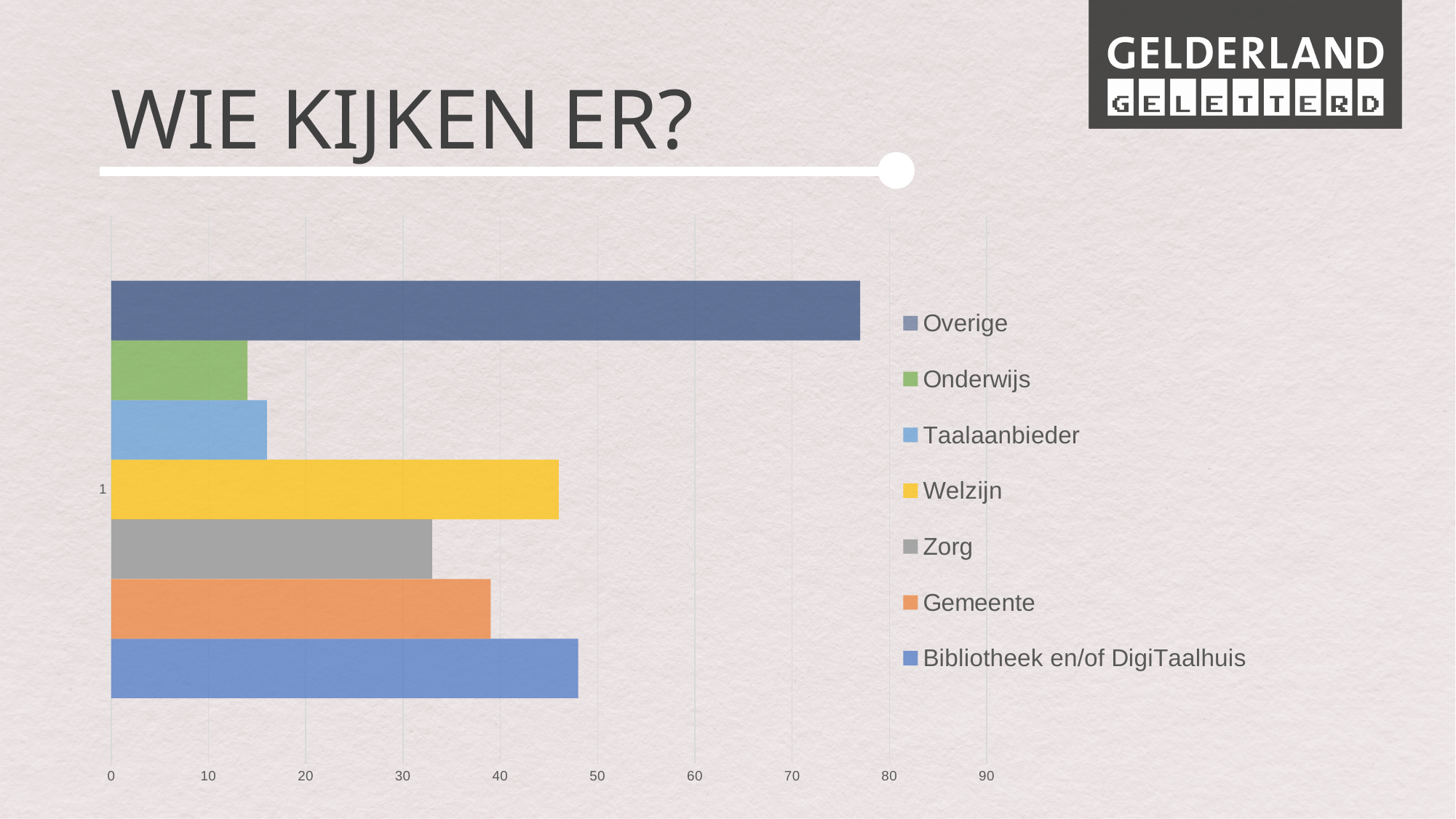
Is the value for Bibliotheek en/of DigiTaalhuis greater or less than 50? less Is the value for Onderwijs greater or less than 20? less What kind of chart is shown on the slide? bar chart Is the value for Overige greater or less than 70? greater Which series has the longest bar? Overige How many series does the legend list? 7 What is the title of the slide containing the chart? WIE KIJKEN ER? Which series is shown in yellow in the legend? Welzijn Which is larger, the value for Gemeente or the value for Zorg? Gemeente Which is larger, the value for Welzijn or the value for Zorg? Welzijn